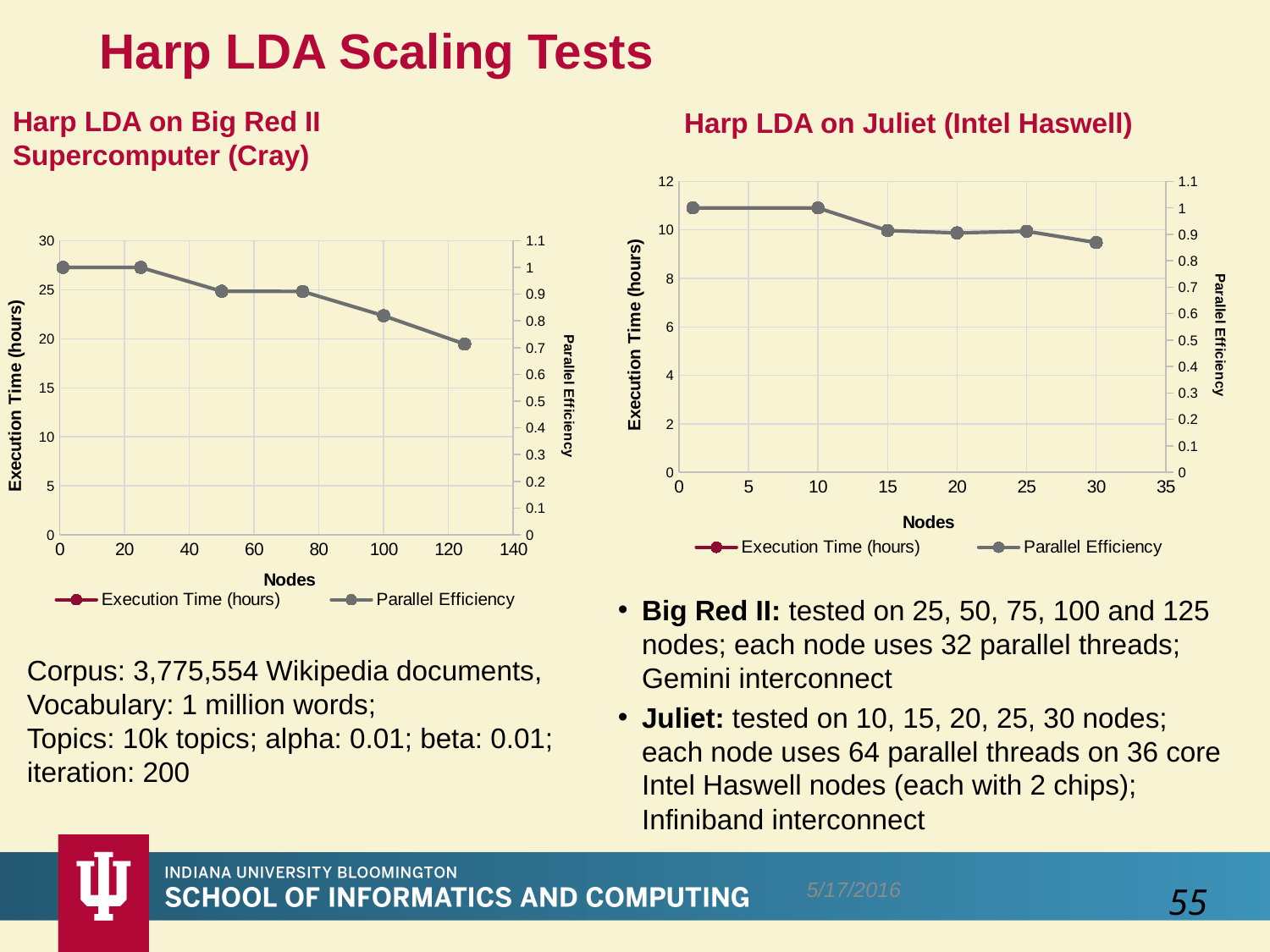
In the Harp LDA on Big Red II Supercomputer (Cray) chart, is the Parallel Efficiency at 50 nodes greater or less than 0.8? greater What type of chart is the Harp LDA on Big Red II Supercomputer (Cray) chart? Line chart What is the label of the x axis in the Harp LDA on Juliet (Intel Haswell) chart? Nodes In the Harp LDA on Juliet (Intel Haswell) chart, is the Parallel Efficiency at 30 nodes greater or less than 0.8? greater In the Harp LDA on Big Red II Supercomputer (Cray) chart, does Parallel Efficiency rise or fall as the number of nodes increases? Fall In the Harp LDA on Juliet (Intel Haswell) chart, is the Parallel Efficiency at 10 nodes greater or less than 0.9? greater In the Harp LDA on Juliet (Intel Haswell) chart, does Parallel Efficiency rise or fall as the number of nodes increases? Fall In the Harp LDA on Big Red II Supercomputer (Cray) chart, at which number of nodes is Parallel Efficiency lowest? 125 How many data points are plotted for Parallel Efficiency in the Harp LDA on Juliet (Intel Haswell) chart? 6 How many series does the legend of the Harp LDA on Juliet (Intel Haswell) chart list? 2 In the Harp LDA on Big Red II Supercomputer (Cray) chart, which is larger: Parallel Efficiency at 25 nodes or at 125 nodes? 25 nodes